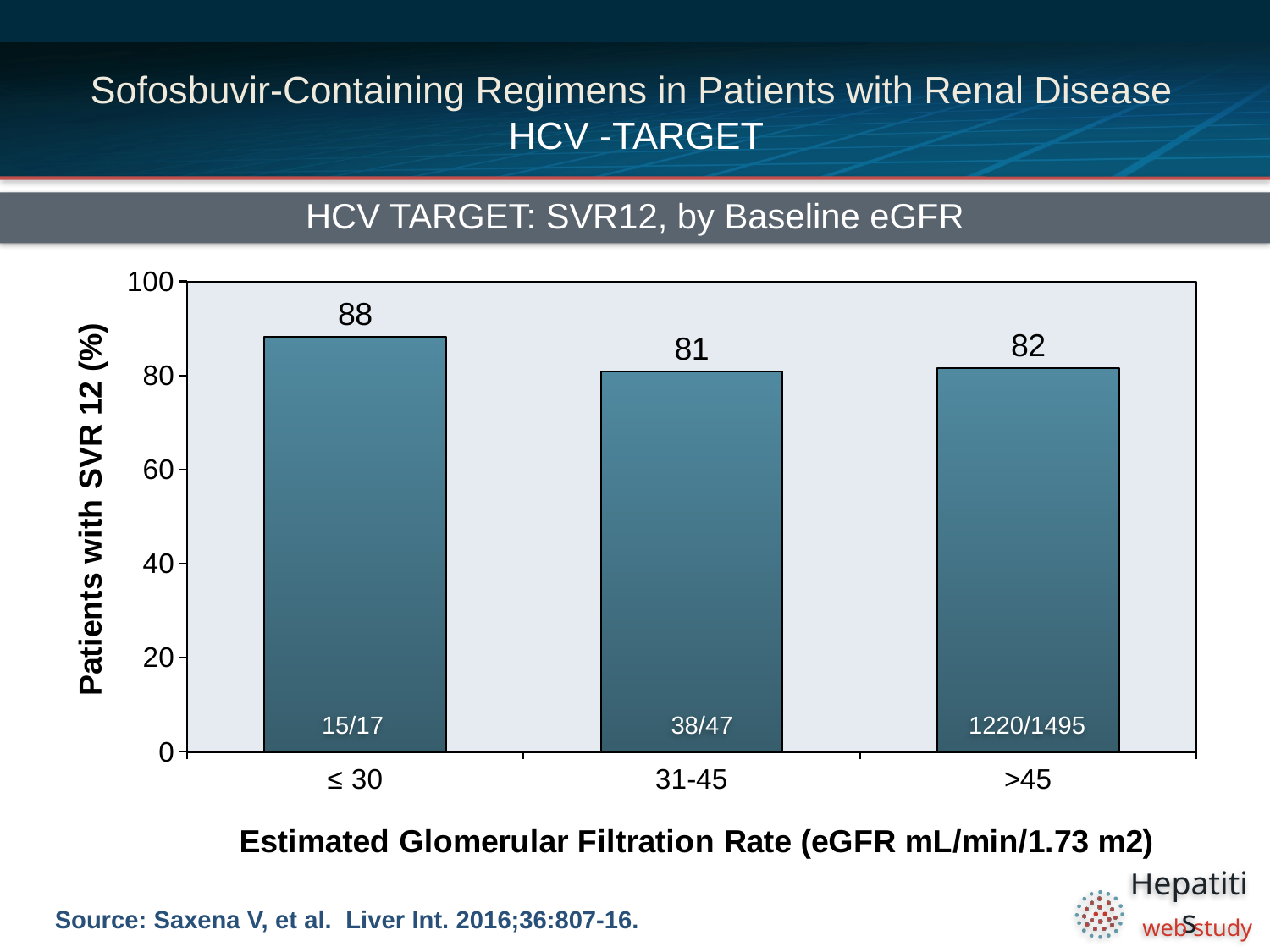
Which group has a higher SVR12 rate, ≤ 30 or >45? ≤ 30 What fraction of patients achieved SVR12 in the >45 eGFR group? 1220/1495 What is the difference in SVR12 rate between the ≤ 30 group and the 31-45 group? 7 What is the SVR12 rate for patients with baseline eGFR 31-45? 81 How many eGFR groups are shown in the chart? 3 What is the SVR12 rate for patients with baseline eGFR ≤ 30? 88 Which eGFR group has the lowest SVR12 rate? 31-45 What fraction of patients achieved SVR12 in the 31-45 eGFR group? 38/47 What type of chart is shown on the slide? Bar chart What is the SVR12 rate for patients with baseline eGFR >45? 82 Which eGFR group has the highest SVR12 rate? ≤ 30 What is the title of the chart? HCV TARGET: SVR12, by Baseline eGFR